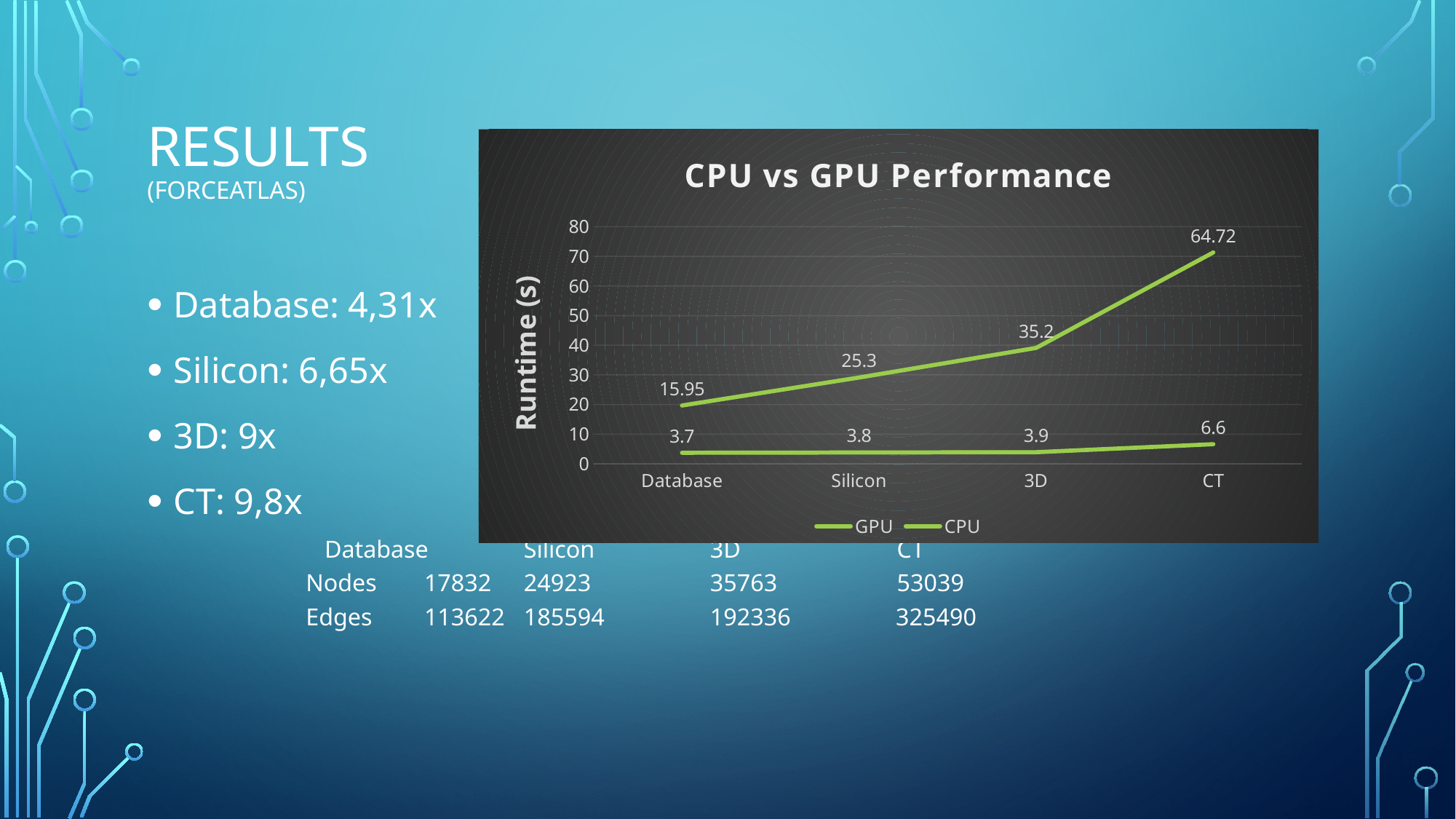
What is the value of the lower line at Database? 3.7 What is the value of the upper line at CT? 64.72 What is the difference between the two plotted values at Database? 12.25 What is the difference between the two plotted values at CT? 58.12 What kind of chart is shown on the slide? Line chart What is the title of the chart? CPU vs GPU Performance What is the label of the vertical axis of the chart? Runtime (s) How many series does the chart legend list? 2 Does the upper line rise or fall from Database to CT? Rise How many categories are shown on the x axis of the chart? 4 At which category does the upper line reach its highest value? CT What is the value of the upper line at Silicon? 25.3